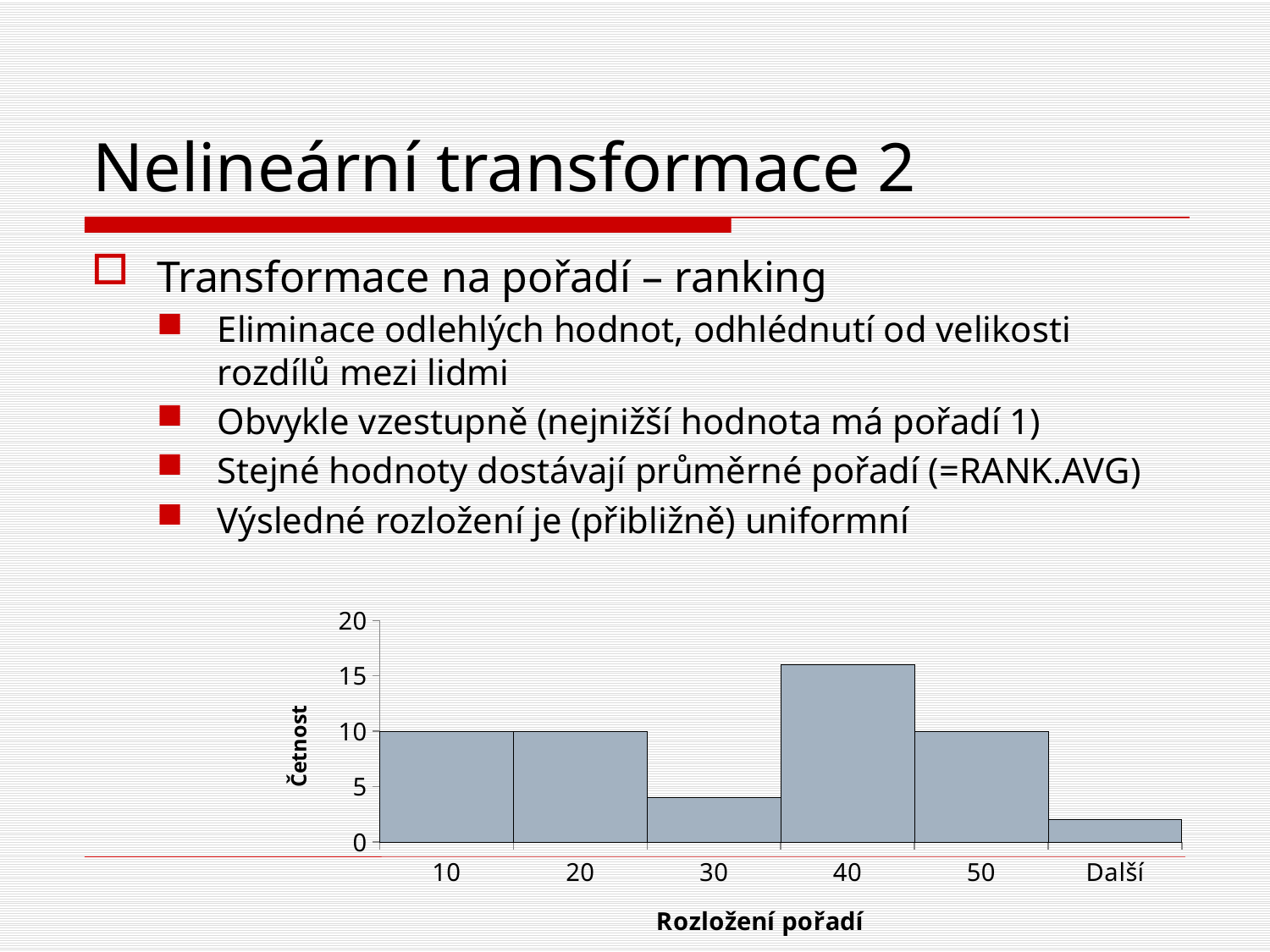
Is the value for category 30 greater or less than 5? less What is the value (Četnost) for the category 50? 10 Which category has the lowest value in the chart? Další What is the value (Četnost) for the category 20? 10 How many categories are shown on the x axis of the chart? 6 Is the value for category 40 greater or less than 15? greater What is the title of the y axis of the chart? Četnost Which category has the highest value in the chart? 40 What is the value (Četnost) for the category 10? 10 What type of chart is shown on the slide? bar chart Which has a larger value, category 40 or category 30? 40 What is the title of the x axis of the chart? Rozložení pořadí